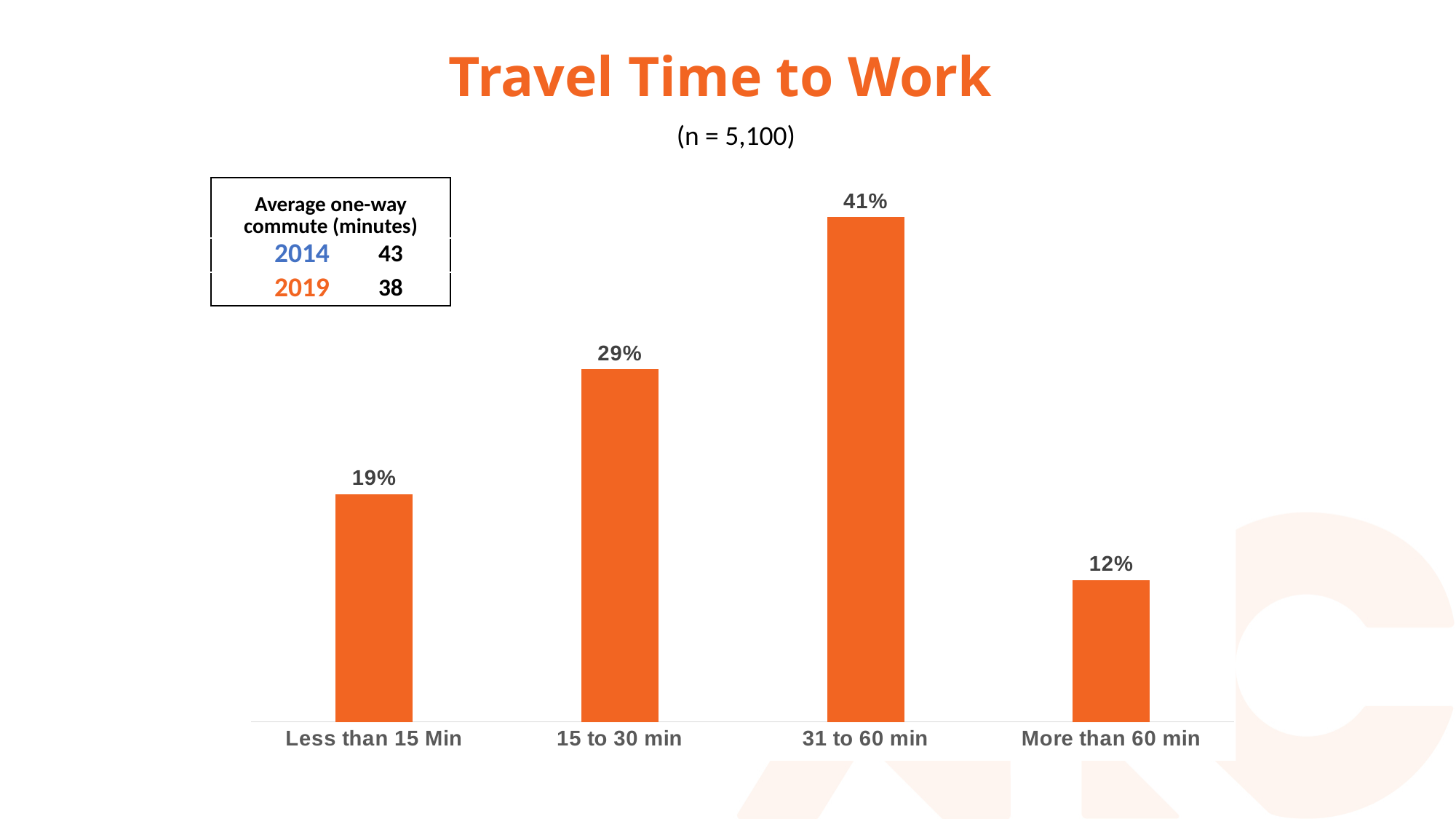
What percentage of respondents travel more than 60 minutes to work? 12% What percentage of respondents have a travel time to work of less than 15 minutes? 19% Which travel time category has the lowest percentage? More than 60 min According to the box on the slide, what was the average one-way commute in minutes in 2019? 38 What is the sample size (n) stated under the chart title? 5,100 Which travel time category has the highest percentage? 31 to 60 min How many travel time categories are shown in the chart? 4 What is the value shown for the '31 to 60 min' category? 41% Which is larger: the value for 'Less than 15 Min' or the value for 'More than 60 min'? Less than 15 Min What is the value shown for the '15 to 30 min' category? 29% What is the difference in percentage points between the '31 to 60 min' and '15 to 30 min' categories? 12 What kind of chart is shown on the slide? Bar chart